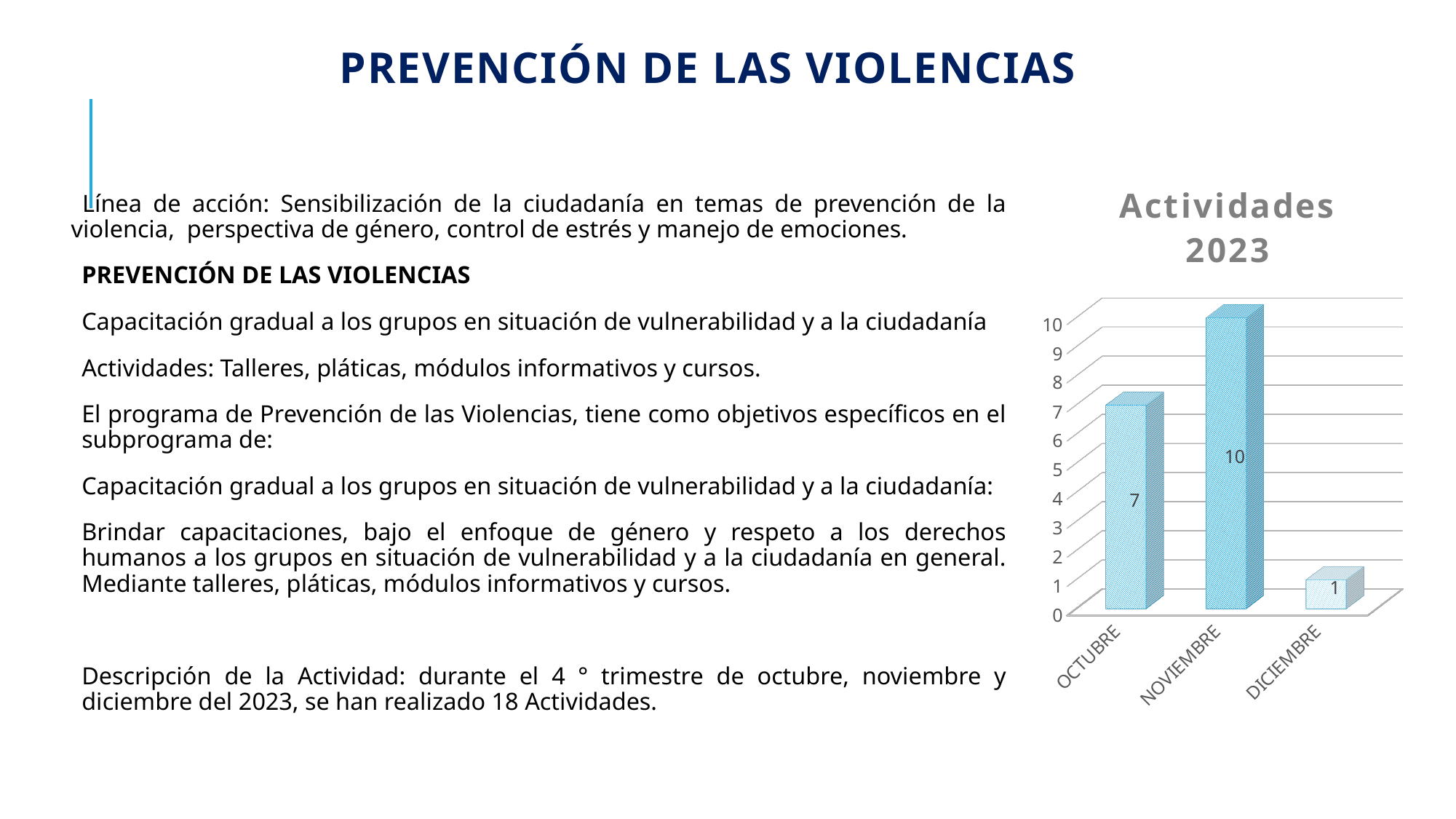
What is the value for OCTUBRE in the Actividades 2023 chart? 7 What is the difference between the values for OCTUBRE and DICIEMBRE in the Actividades 2023 chart? 6 What is the value for DICIEMBRE in the Actividades 2023 chart? 1 How many categories are shown in the Actividades 2023 chart? 3 What is the difference between the values for NOVIEMBRE and OCTUBRE in the Actividades 2023 chart? 3 What is the total of the three values shown in the Actividades 2023 chart? 18 What is the value for NOVIEMBRE in the Actividades 2023 chart? 10 What kind of chart is the Actividades 2023 chart? bar chart Which month has the highest value in the Actividades 2023 chart? NOVIEMBRE Which is larger in the Actividades 2023 chart, OCTUBRE or DICIEMBRE? OCTUBRE What is the title of the chart on the slide? Actividades 2023 Which month has the lowest value in the Actividades 2023 chart? DICIEMBRE